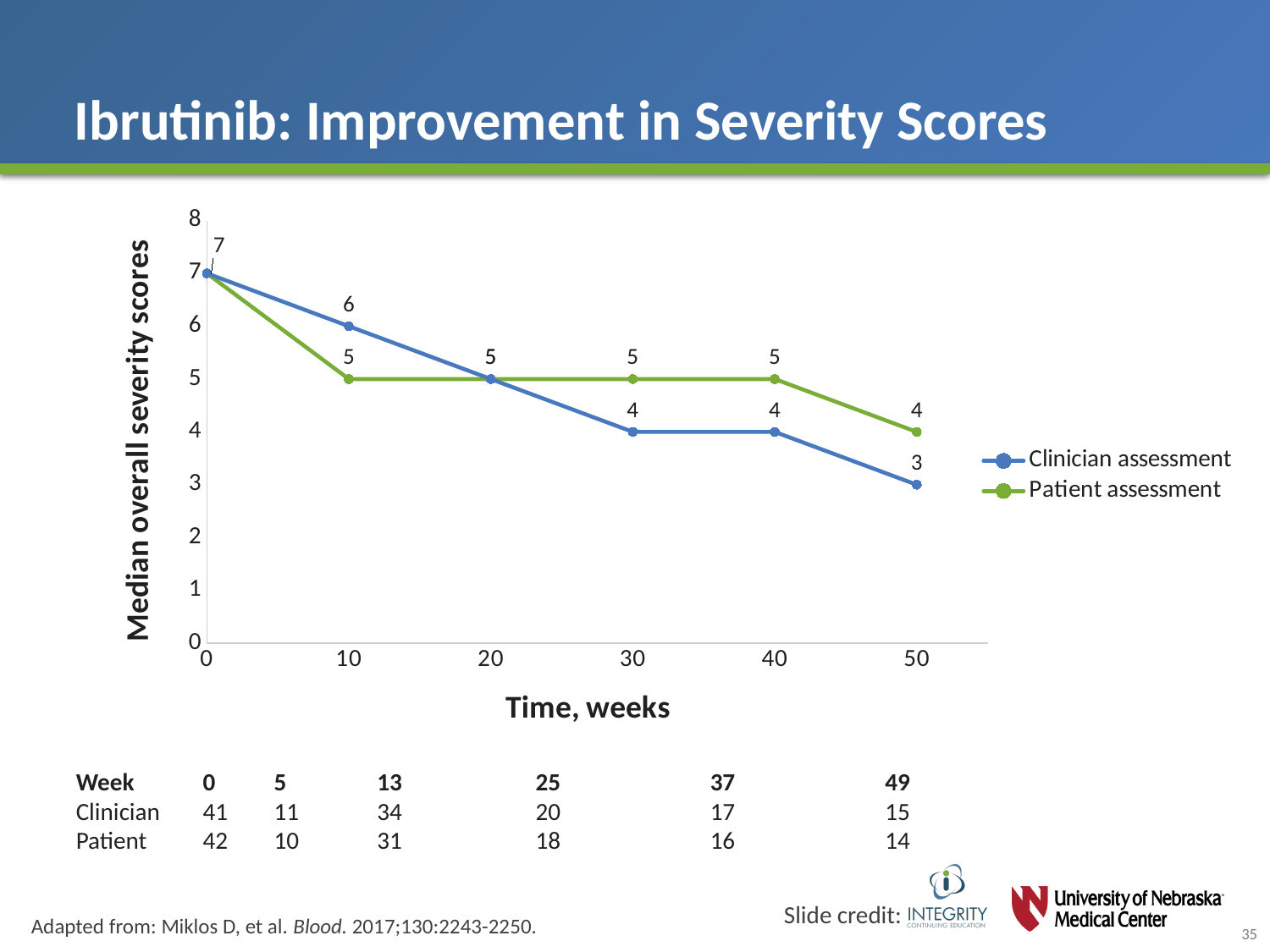
What is the Clinician assessment median overall severity score at week 50? 3 What is the Clinician assessment median overall severity score at week 10? 6 How many time points are plotted for each series? 6 How does the Clinician assessment score change from week 0 to week 50? It falls What is the Patient assessment median overall severity score at week 30? 5 How many series does the chart legend list? 2 What is the label of the y axis? Median overall severity scores What is the median overall severity score for both assessments at week 0? 7 What is the difference between the Patient assessment and Clinician assessment scores at week 10? 1 What type of chart is shown on the slide? line chart At week 40, which series has the higher median overall severity score, Clinician assessment or Patient assessment? Patient assessment What is the Patient assessment median overall severity score at week 50? 4